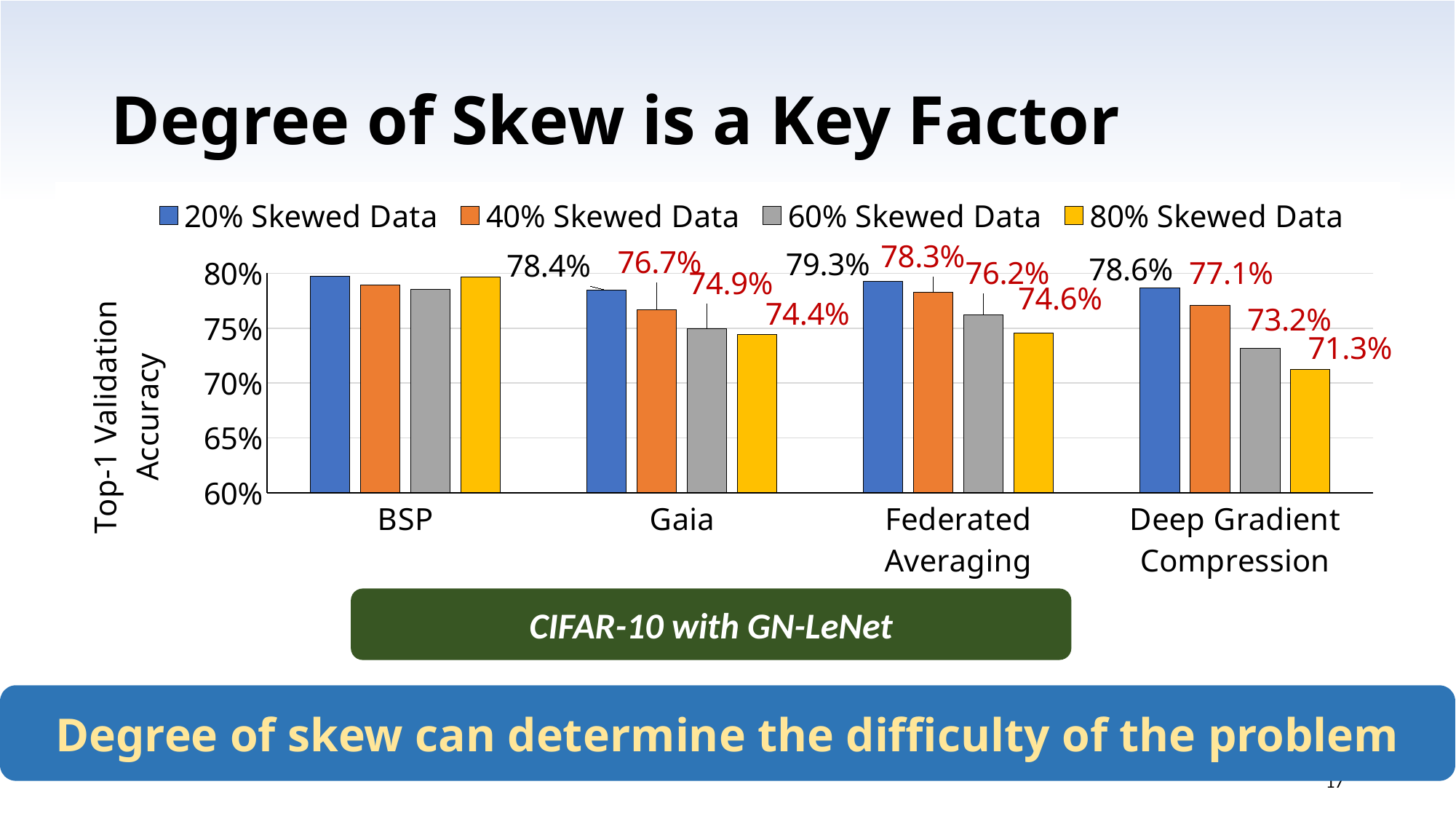
What is the Top-1 validation accuracy for Federated Averaging with 60% skewed data? 76.2% What is the Top-1 validation accuracy for Deep Gradient Compression with 80% skewed data? 71.3% Among the labeled values, which bar has the lowest accuracy? Deep Gradient Compression, 80% Skewed Data How many categories (systems) are shown on the x axis? 4 Is the value for BSP with 60% skewed data greater or less than 75%? greater What is the Top-1 validation accuracy for Gaia with 20% skewed data? 78.4% What is the difference between the 20% skewed and 80% skewed accuracies for Deep Gradient Compression? 7.3% For Deep Gradient Compression, does accuracy rise or fall as the degree of skew increases from 20% to 80%? Fall How many series does the legend list? 4 What kind of chart is shown on the slide? Bar chart What is the difference between the 40% skewed and 60% skewed accuracies for Gaia? 1.8% Which is larger for 80% skewed data: the accuracy of Federated Averaging or of Deep Gradient Compression? Federated Averaging